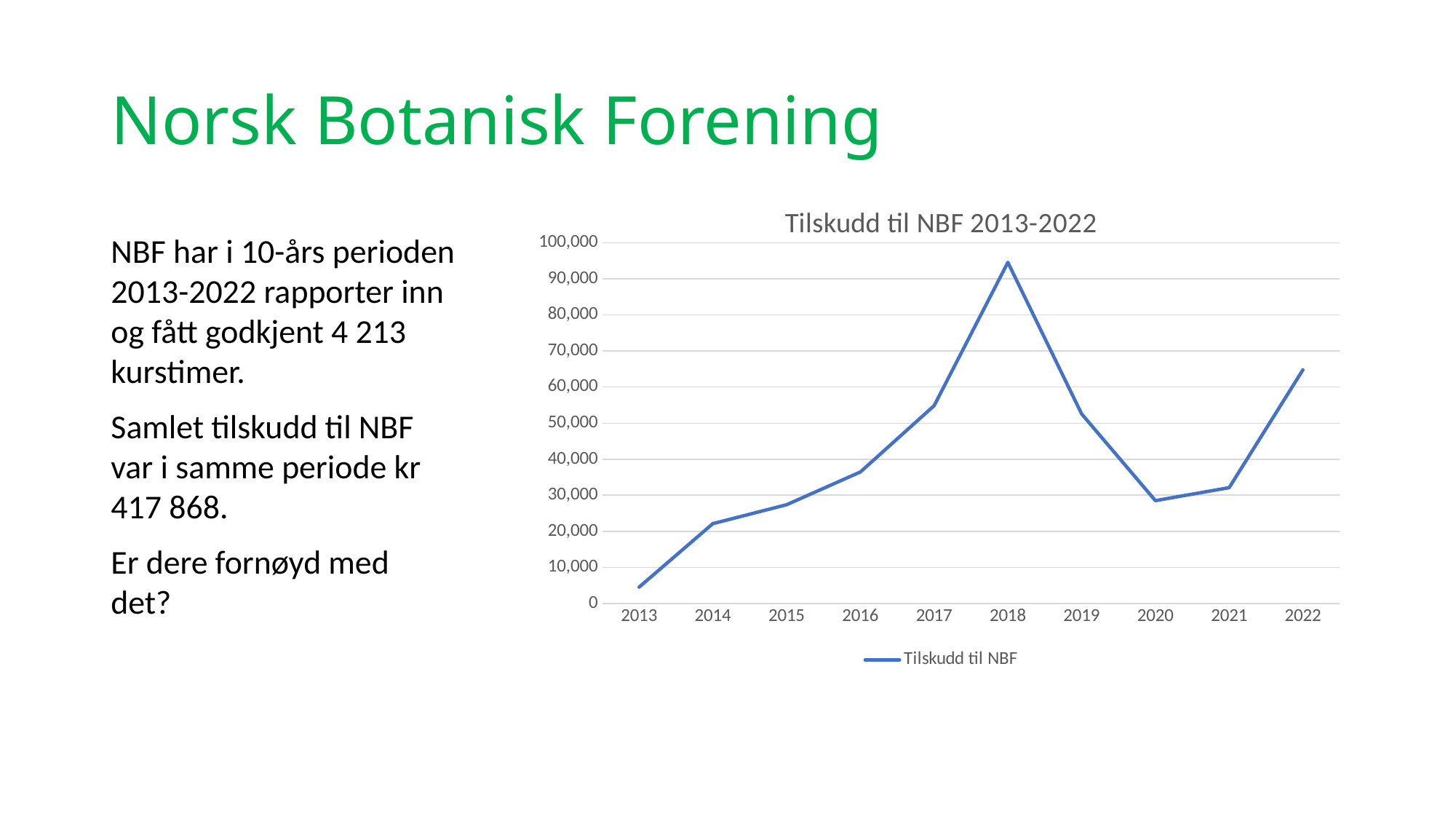
Is the value for 2018 greater or less than 90,000? greater In which year is the value for Tilskudd til NBF highest? 2018 Is the value for 2020 greater or less than 30,000? less What is the title of the chart? Tilskudd til NBF 2013-2022 Which year has the larger value, 2017 or 2019? 2017 In which year is the value for Tilskudd til NBF lowest? 2013 Is the value for 2013 greater or less than 10,000? less What kind of chart is shown on the slide? line chart How many years are plotted on the x axis of the chart? 10 How many series does the chart legend list? 1 Do the values rise or fall from 2013 to 2018? rise